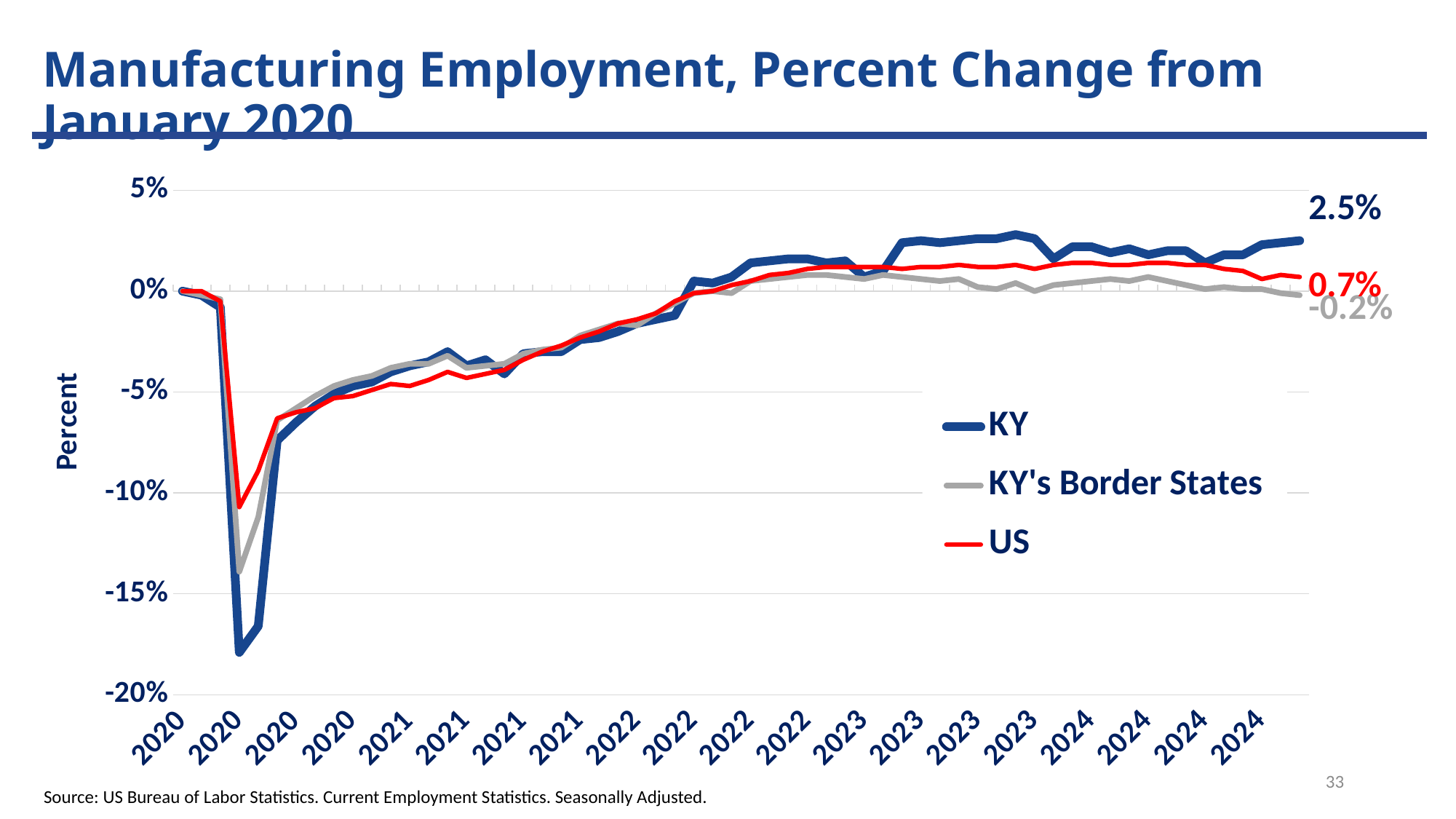
Is the lowest point of the KY line in 2020 greater or less than -15%? less What is the final labelled value for the KY's Border States series? -0.2% Is the lowest point of the US line in 2020 greater or less than -15%? greater Which series fell the furthest during the 2020 drop? KY What is the final labelled value for the US series? 0.7% Which series has the highest value at the end of the chart? KY What kind of chart is shown on the slide? Line chart How many series does the legend list? 3 What is the final labelled value for the KY series? 2.5% At the end of the chart, which is larger: the KY value or the US value? KY Which series has the lowest value at the end of the chart? KY's Border States What is the difference between the final labelled values for KY and US? 1.8 percentage points